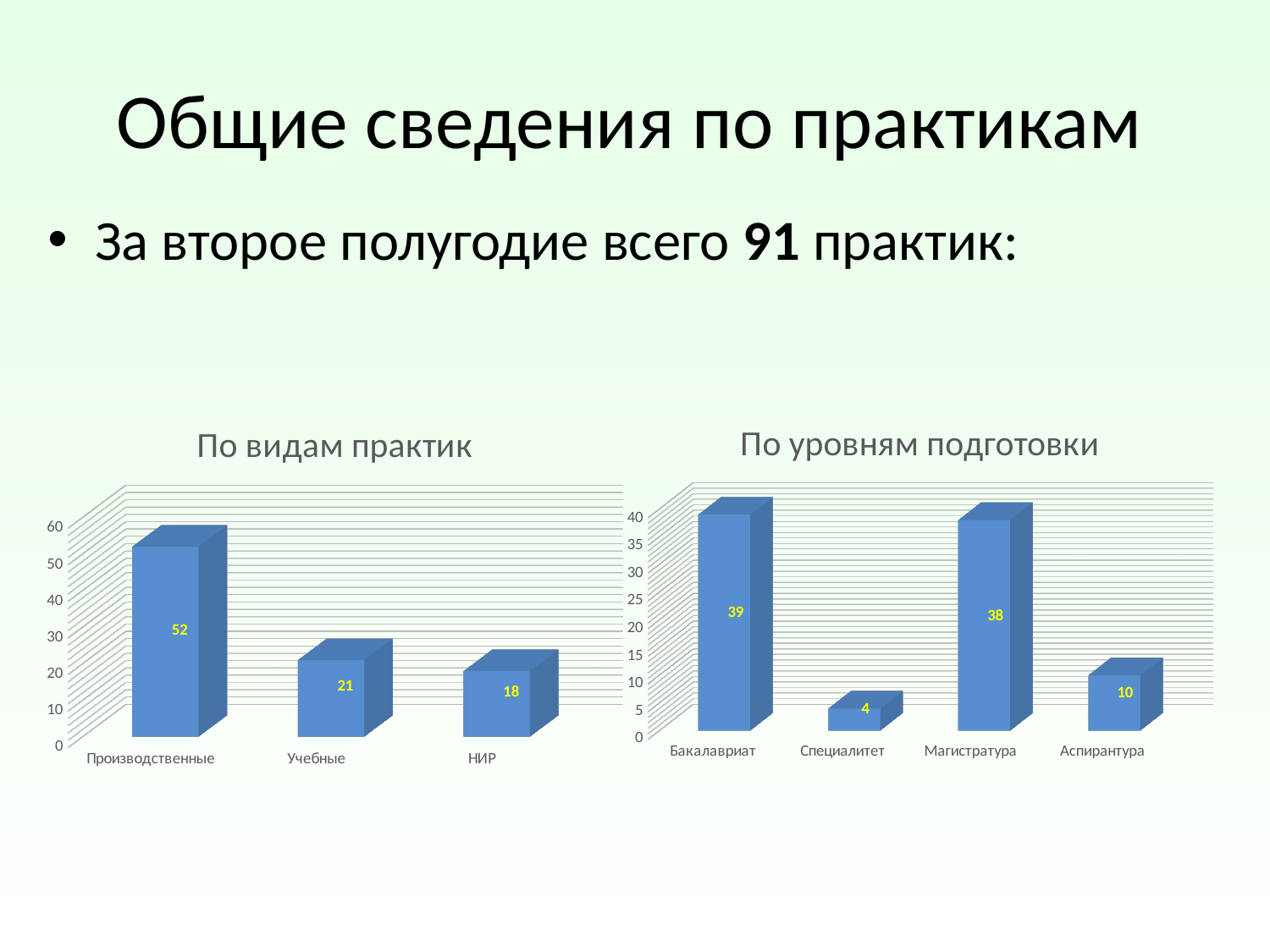
In the chart 'По уровням подготовки', what is the difference between Бакалавриат and Аспирантура? 29 In the chart 'По видам практик', what is the value for НИР? 18 In the chart 'По уровням подготовки', which is larger, Бакалавриат or Аспирантура? Бакалавриат In the chart 'По видам практик', how many categories are shown? 3 In the chart 'По уровням подготовки', how many categories are shown? 4 In the chart 'По уровням подготовки', which category has the lowest value? Специалитет In the chart 'По уровням подготовки', what is the value for Магистратура? 38 In the chart 'По уровням подготовки', what is the value for Специалитет? 4 In the chart 'По видам практик', which category has the highest value? Производственные In the chart 'По видам практик', what is the value for Производственные? 52 In the chart 'По видам практик', what is the difference between Производственные and Учебные? 31 What type of chart is 'По уровням подготовки'? Bar chart